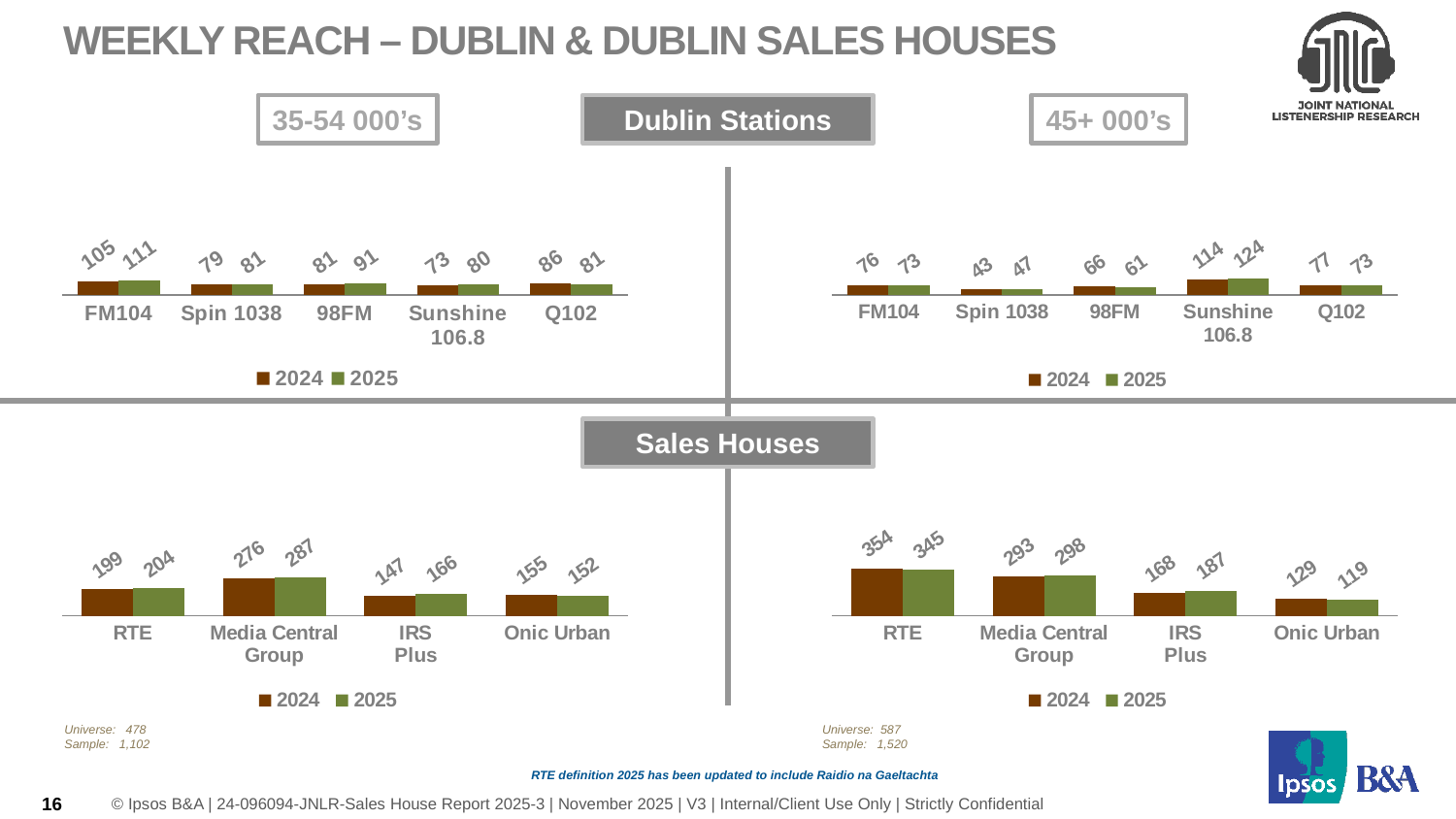
In the bottom-left chart (Sales Houses, 35-54 000's), what is the 2025 value for IRS Plus? 166 In the bottom-right chart (Sales Houses, 45+ 000's), which sales house has the highest 2024 value? RTE In the bottom-right chart (Sales Houses, 45+ 000's), what is the difference between the 2025 and 2024 values for IRS Plus? 19 In the top-left chart (Dublin Stations, 35-54 000's), which is larger for Q102, the 2024 value or the 2025 value? 2024 In the top-right chart (Dublin Stations, 45+ 000's), which station has the lowest 2025 value? Spin 1038 In the top-right chart (Dublin Stations, 45+ 000's), what is the 2024 value for Sunshine 106.8? 114 What kind of chart is the bottom-right chart (Sales Houses, 45+ 000's)? Bar chart How many series does the legend list in the bottom-left chart (Sales Houses, 35-54 000's)? 2 In the bottom-left chart (Sales Houses, 35-54 000's), which is larger for Onic Urban, the 2024 value or the 2025 value? 2024 In the top-left chart (Dublin Stations, 35-54 000's), what is the difference between the 2025 and 2024 values for 98FM? 10 In the top-left chart (Dublin Stations, 35-54 000's), what is the 2025 value for FM104? 111 How many stations are shown in the top-right chart (Dublin Stations, 45+ 000's)? 5